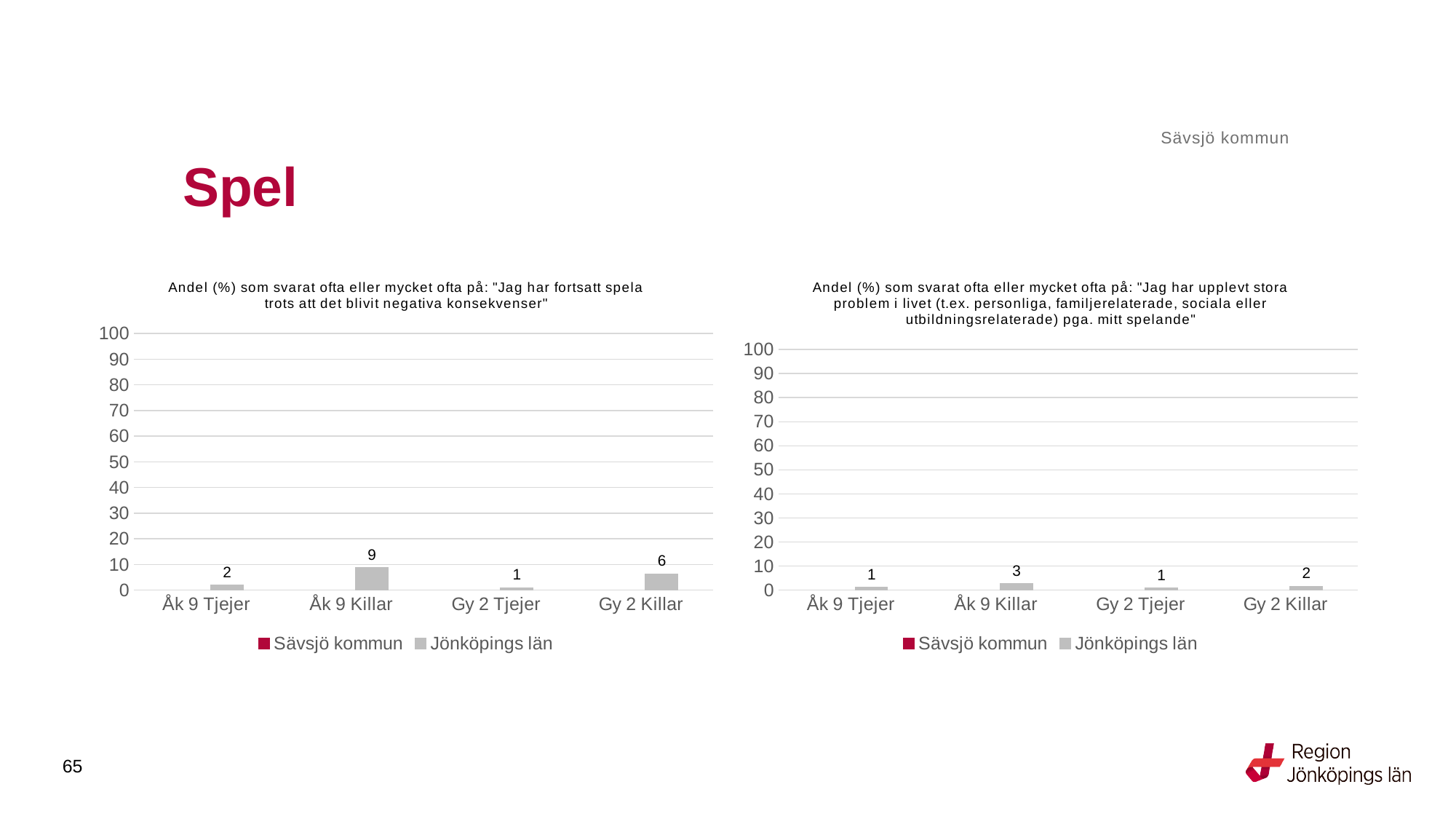
In the right chart, which category has the highest Jönköpings län value? Åk 9 Killar In the right chart, what is the value for Jönköpings län for Gy 2 Killar? 2 In the right chart, is the Jönköpings län value for Åk 9 Killar greater or less than 10? less In the left chart, what is the value for Jönköpings län for Gy 2 Killar? 6 In the left chart, what is the value for Jönköpings län for Åk 9 Killar? 9 In the left chart, which category has the lowest Jönköpings län value? Gy 2 Tjejer In the left chart, what is the difference between the Jönköpings län values for Åk 9 Killar and Gy 2 Killar? 3 What type of chart is the left chart? bar chart In the left chart, which category has the highest Jönköpings län value? Åk 9 Killar How many series does the legend of the right chart list? 2 In the right chart, what is the value for Jönköpings län for Åk 9 Killar? 3 In the left chart, how many categories are shown on the x axis? 4